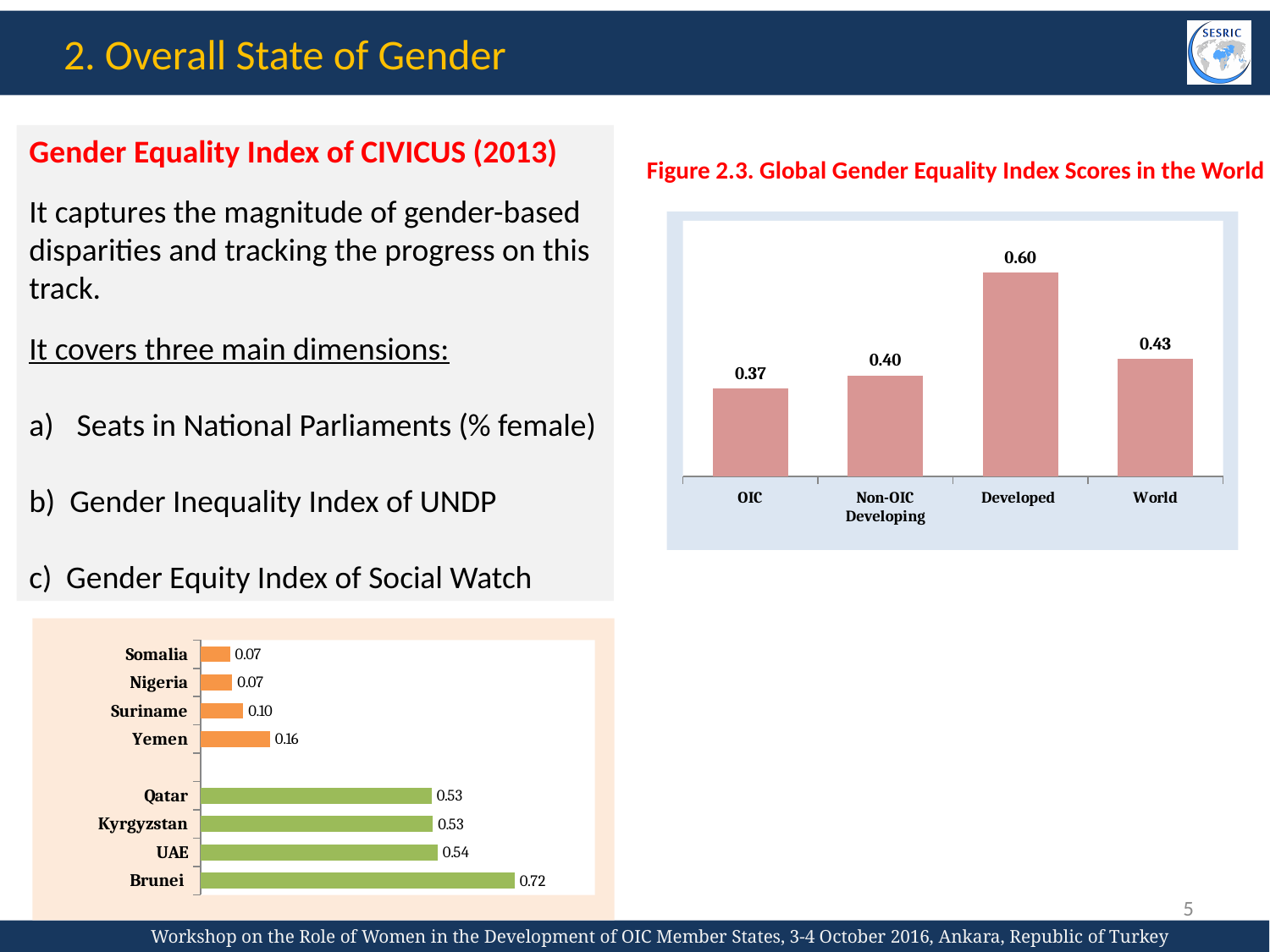
In the chart at the bottom left of the slide, how many countries are shown? 8 In Figure 2.3, how many categories are shown on the x axis? 4 In the chart at the bottom left of the slide, what is the value for Brunei? 0.72 In Figure 2.3, what is the score for Non-OIC Developing? 0.40 In Figure 2.3, what is the Global Gender Equality Index score for OIC? 0.37 In Figure 2.3, what is the difference between the Developed score and the World score? 0.17 What type of chart is Figure 2.3? Bar chart In the chart at the bottom left of the slide, what is the value for Yemen? 0.16 In Figure 2.3, which category has the highest score? Developed In the chart at the bottom left of the slide, is the value for UAE or Suriname larger? UAE In Figure 2.3, which category has the lowest score? OIC In the chart at the bottom left of the slide, which country has the highest value? Brunei